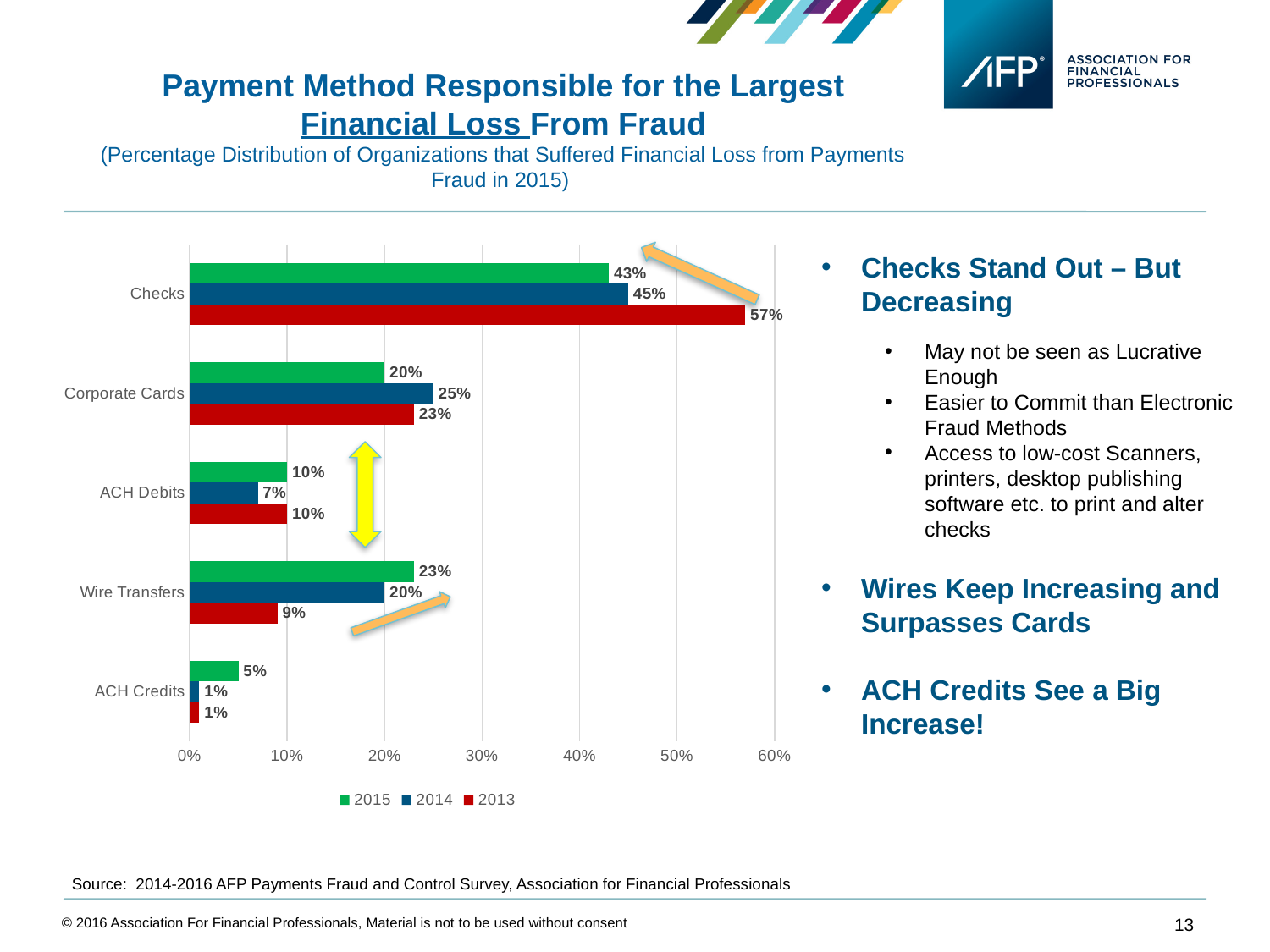
What percentage is shown for Checks in 2015? 43% What percentage is shown for Wire Transfers in 2013? 9% What percentage is shown for Corporate Cards in 2014? 25% Which payment method has the highest value in 2013? Checks Which is larger for 2015: Wire Transfers or Corporate Cards? Wire Transfers Which payment method has the lowest value in 2015? ACH Credits Is the 2014 value for Checks greater or less than 40%? greater Which years are listed in the chart legend? 2015, 2014, 2013 What kind of chart is shown on the slide? Bar chart What is the difference between the 2013 and 2015 values for Checks? 14% How many series does the legend list? 3 How many payment method categories are shown on the chart? 5